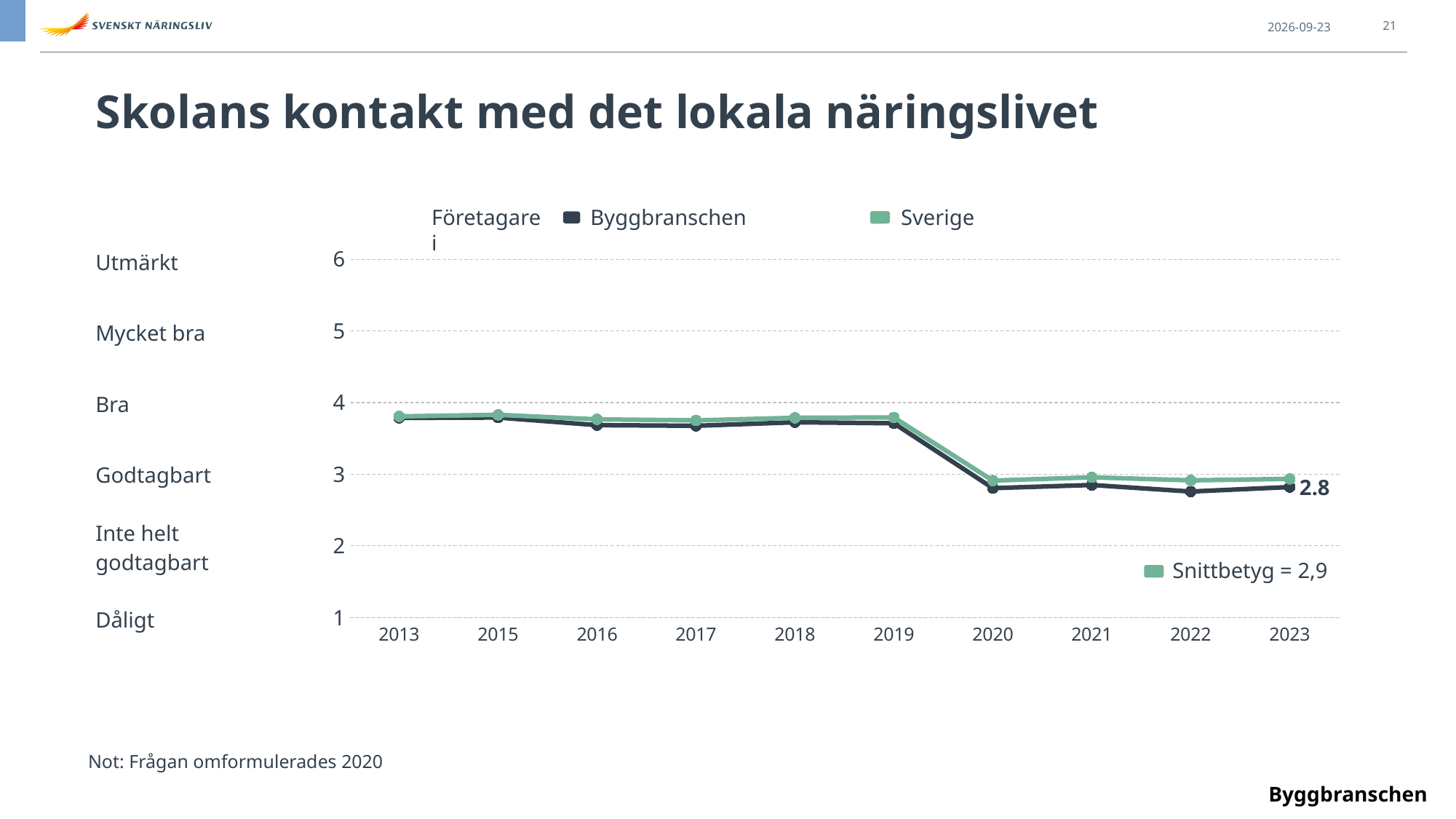
What is the value for Byggbranschen in 2023? 2.8 How many series does the chart legend list? 2 Is the value for Byggbranschen in 2013 greater or less than 3? greater Which is larger for Byggbranschen: the value in 2019 or the value in 2020? 2019 What is the title of the slide's chart? Skolans kontakt med det lokala näringslivet Is the value for Sverige in 2018 greater or less than 4? less How many years are plotted along the x axis? 10 What kind of chart is shown on the slide? line chart Is the value for Byggbranschen in 2020 greater or less than 3? less What Snittbetyg value is shown on the chart? 2,9 Do the values for Byggbranschen rise or fall overall from 2013 to 2023? fall